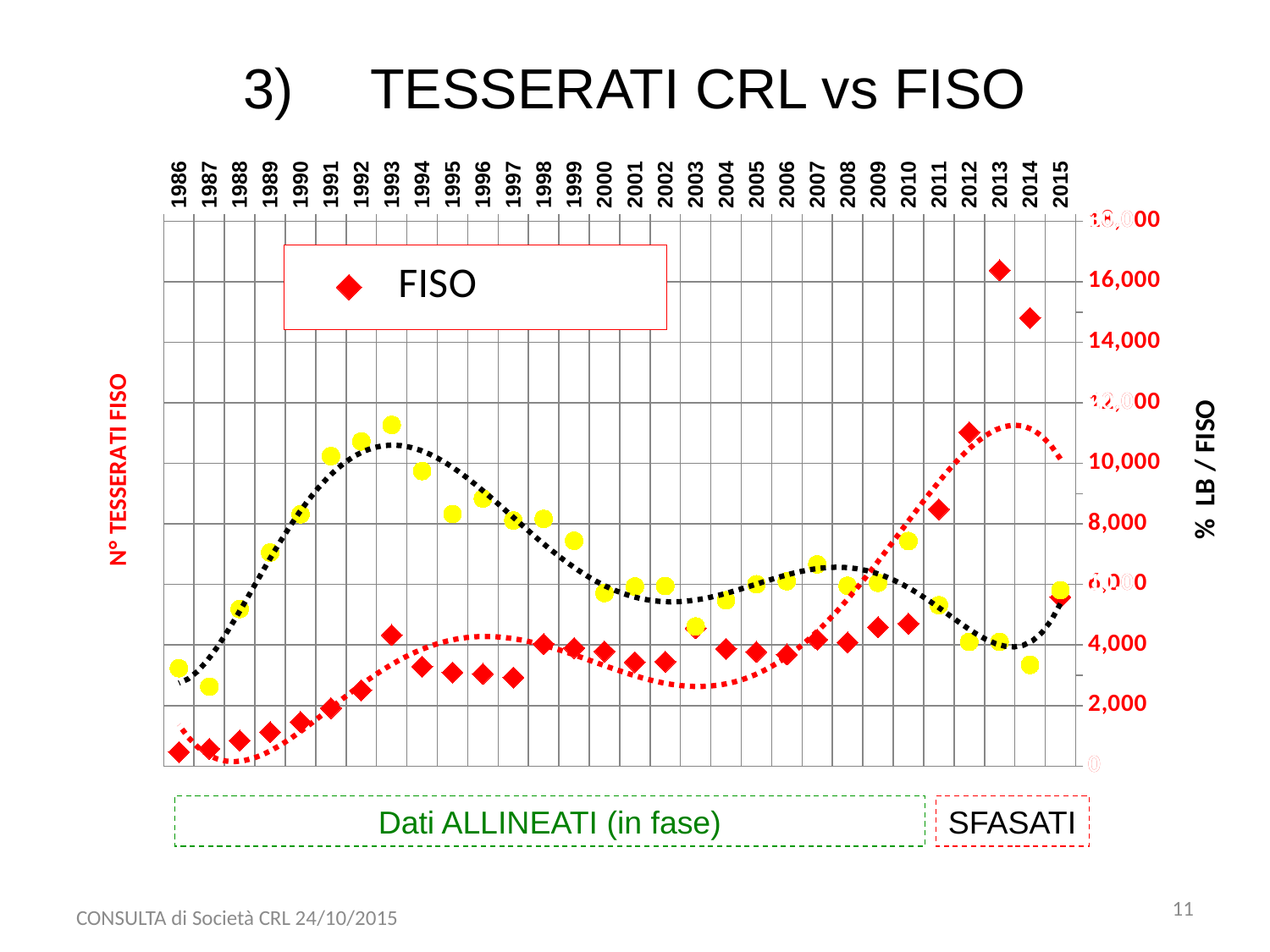
In which year does the yellow-circle series reach its highest value? 1993 In which year does the FISO series reach its highest value? 2013 How many years are shown along the x axis of the chart? 30 What kind of chart is shown on the slide? Scatter chart Which is larger, the FISO value for 2013 or the FISO value for 2014? 2013 In which year does the yellow-circle series reach its lowest value? 1987 How many series does the chart legend list? 1 Is the FISO value for 2013 greater or less than 14,000? greater What is the title of the chart on the slide? TESSERATI CRL vs FISO Does the FISO series rise or fall from 1986 to 1993? rise Is the FISO value for 1986 greater or less than 2,000? less Which series is named in the chart legend? FISO